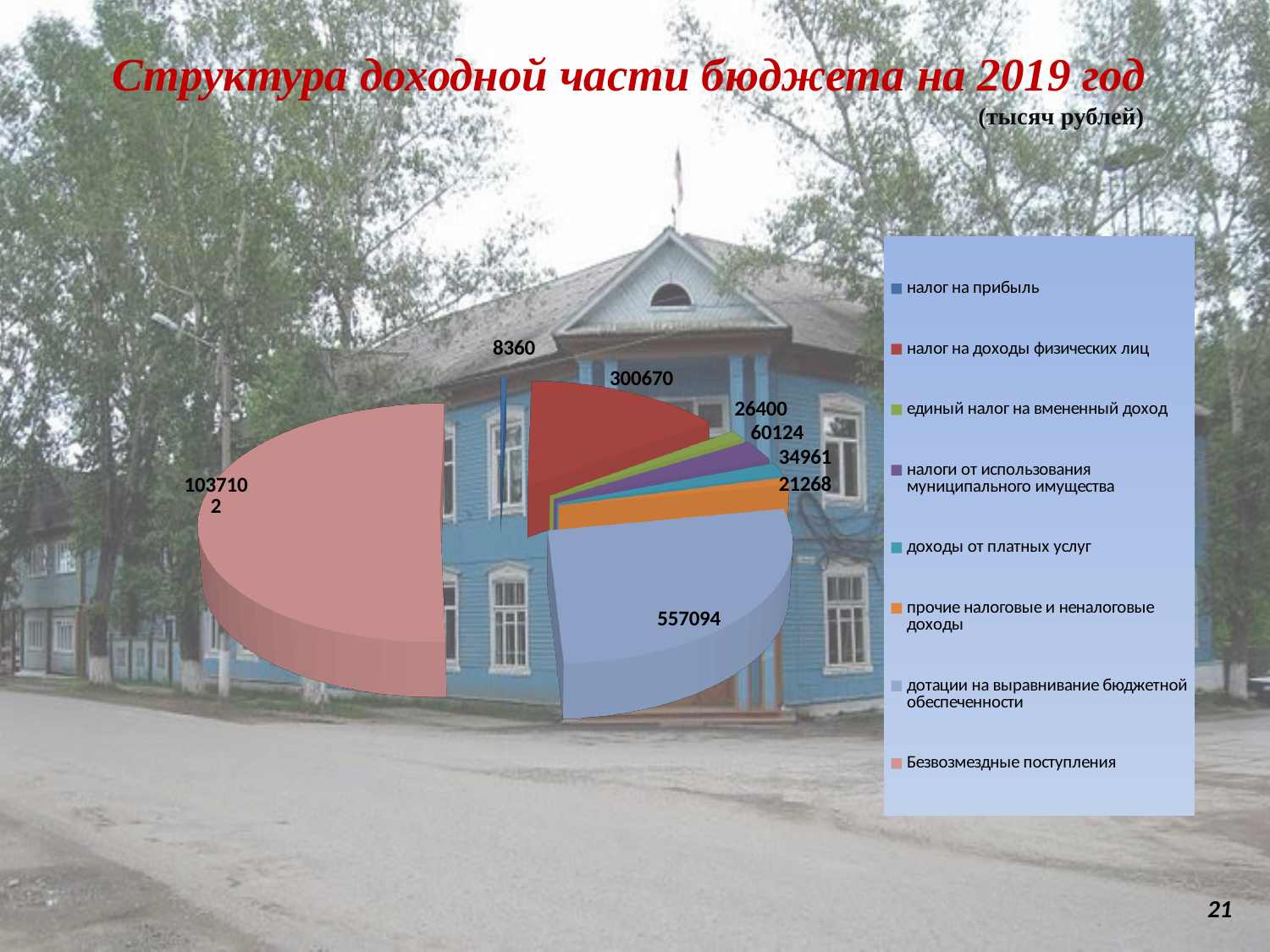
Which is larger: 'налоги от использования муниципального имущества' or 'единый налог на вмененный доход'? налоги от использования муниципального имущества What is the value for 'налог на прибыль'? 8360 What is the value for 'доходы от платных услуг'? 34961 What is the value for 'Безвозмездные поступления'? 1037102 What is the value for 'налог на доходы физических лиц'? 300670 What is the value for 'дотации на выравнивание бюджетной обеспеченности'? 557094 Which category has the smallest slice of the pie? налог на прибыль What kind of chart is shown on the slide? pie chart What is the difference between 'дотации на выравнивание бюджетной обеспеченности' and 'налог на доходы физических лиц'? 256424 What unit is stated under the chart title? тысяч рублей Which category has the largest slice of the pie? Безвозмездные поступления How many categories does the legend of the pie chart list? 8